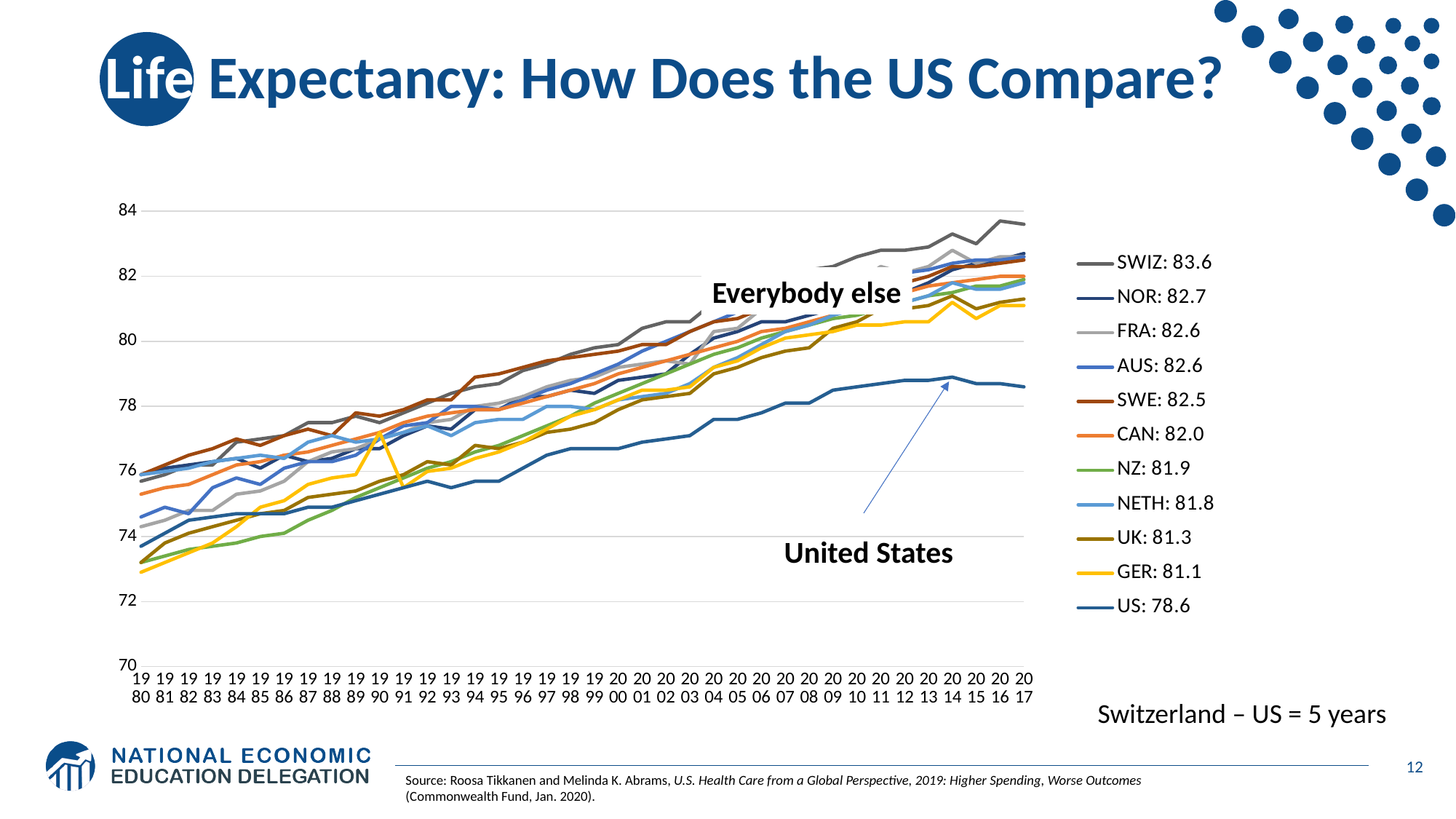
According to the legend, what is the life expectancy value shown for SWIZ? 83.6 Is the value for the US line in 2000 greater or less than 78? less Do the lines generally rise or fall from 1980 to 2017? rise Which country has the lowest value in the legend? US What type of chart is shown on the slide? line chart Which has the larger legend value, CAN or GER? CAN What is the difference between the legend values for SWIZ and US? 5.0 What is the difference between the legend values for NOR and US? 4.1 Which country has the highest value in the legend? SWIZ According to the legend, what is the life expectancy value shown for UK? 81.3 According to the legend, what is the life expectancy value shown for US? 78.6 How many series does the legend list? 11